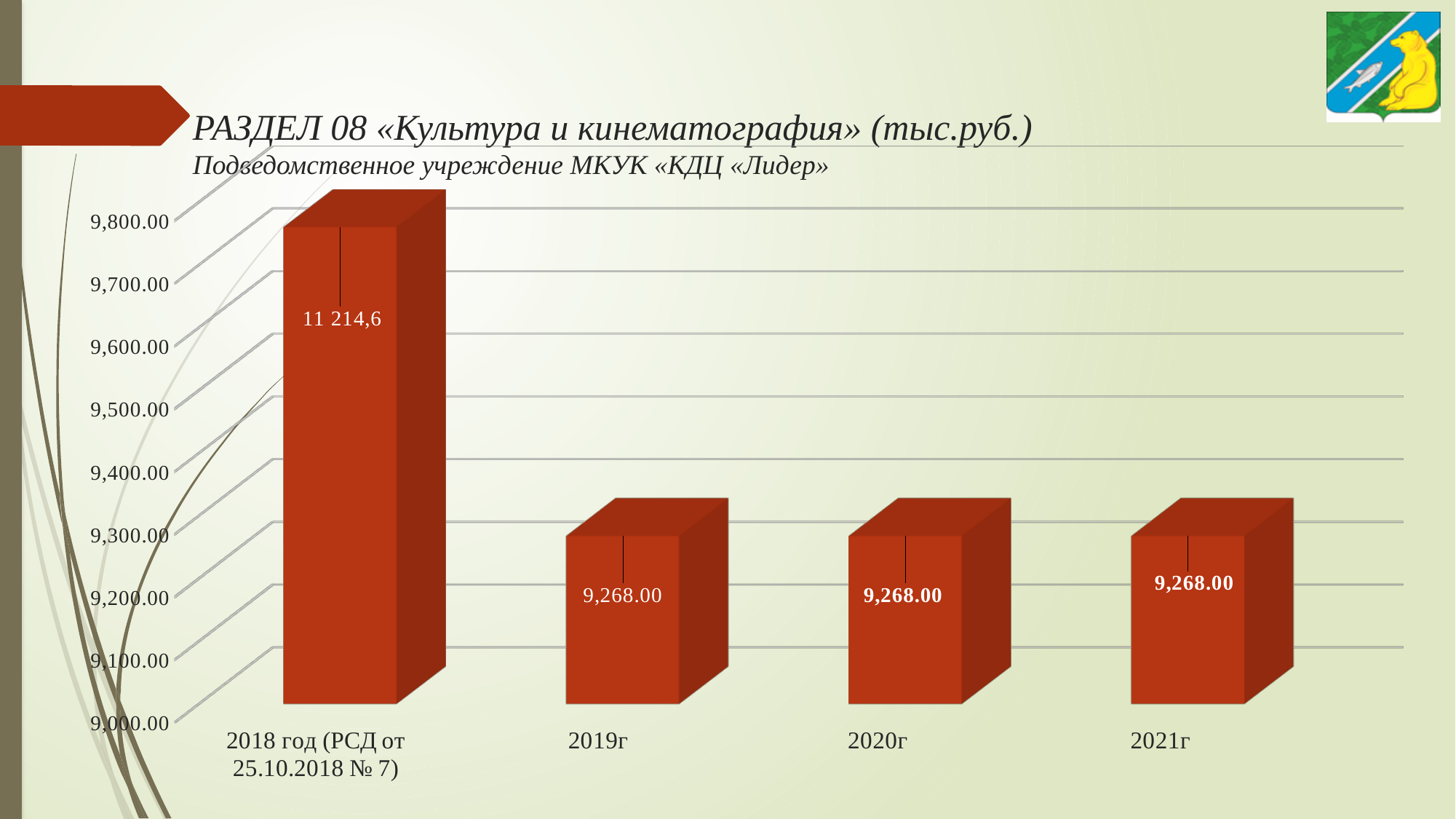
What value is labelled on the bar for 2018 год (РСД от 25.10.2018 № 7)? 11 214,6 Do the values rise or fall from 2018 год to 2019г? fall What kind of chart is shown on the slide? bar chart Which category has the highest bar? 2018 год (РСД от 25.10.2018 № 7) What value is labelled on the bar for 2019г? 9,268.00 What value is labelled on the bar for 2020г? 9,268.00 What is the difference between the values for 2020г and 2021г? 0.00 Which is larger, the value for 2018 год or the value for 2019г? 2018 год What value is labelled on the bar for 2021г? 9,268.00 How many categories are shown on the x axis? 4 How many categories share the value 9,268.00? 3